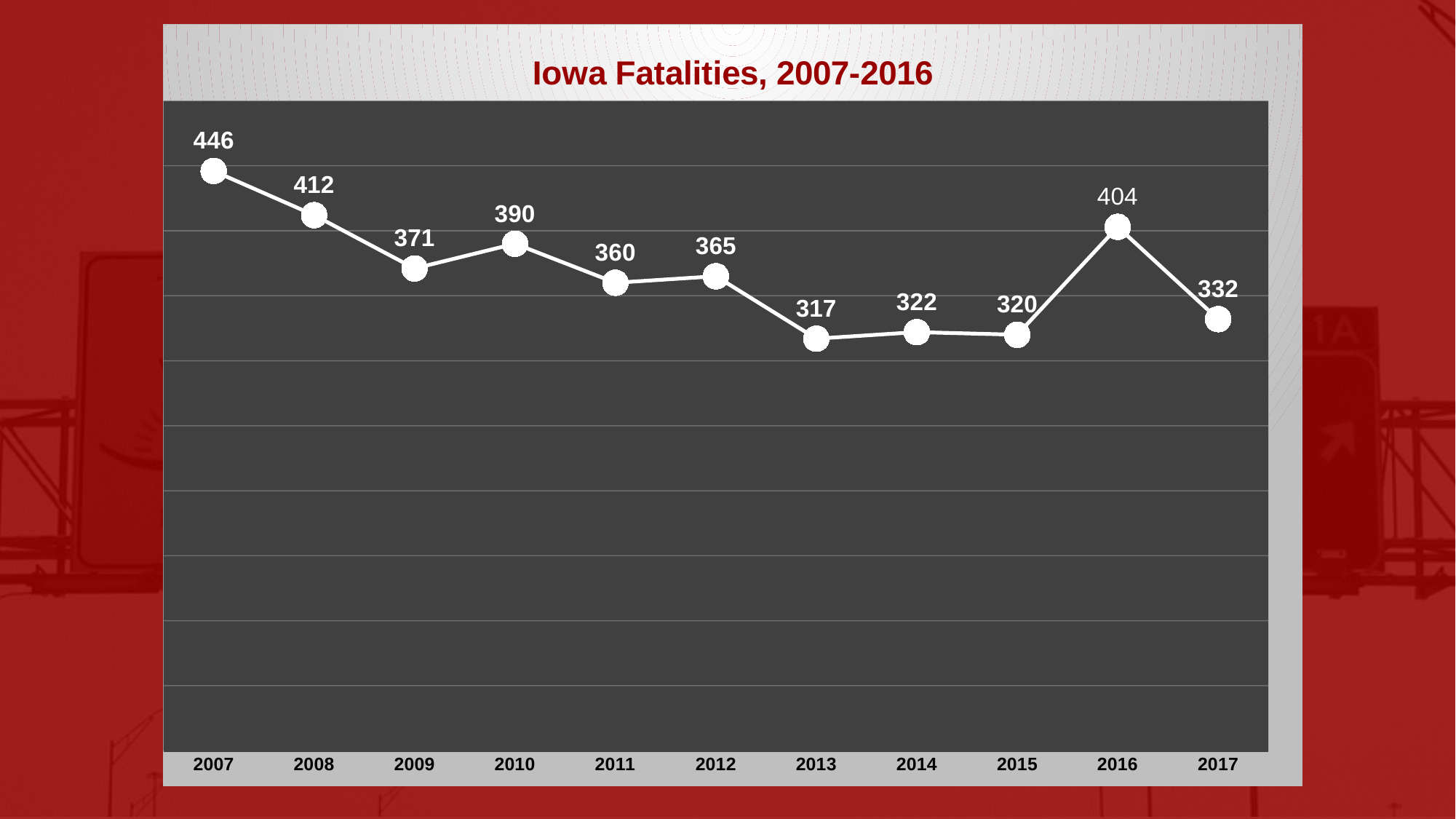
Which year has the lowest value? 2013 Which year has the highest value? 2007 What is the title of the chart? Iowa Fatalities, 2007-2016 Which is larger, the value for 2010 or the value for 2012? 2010 What is the value for 2007? 446 What kind of chart is this? line chart What is the value for 2017? 332 What is the value for 2013? 317 What is the difference between the values for 2016 and 2017? 72 How many years are plotted on the chart? 11 What is the value for 2016? 404 What is the difference between the values for 2007 and 2008? 34